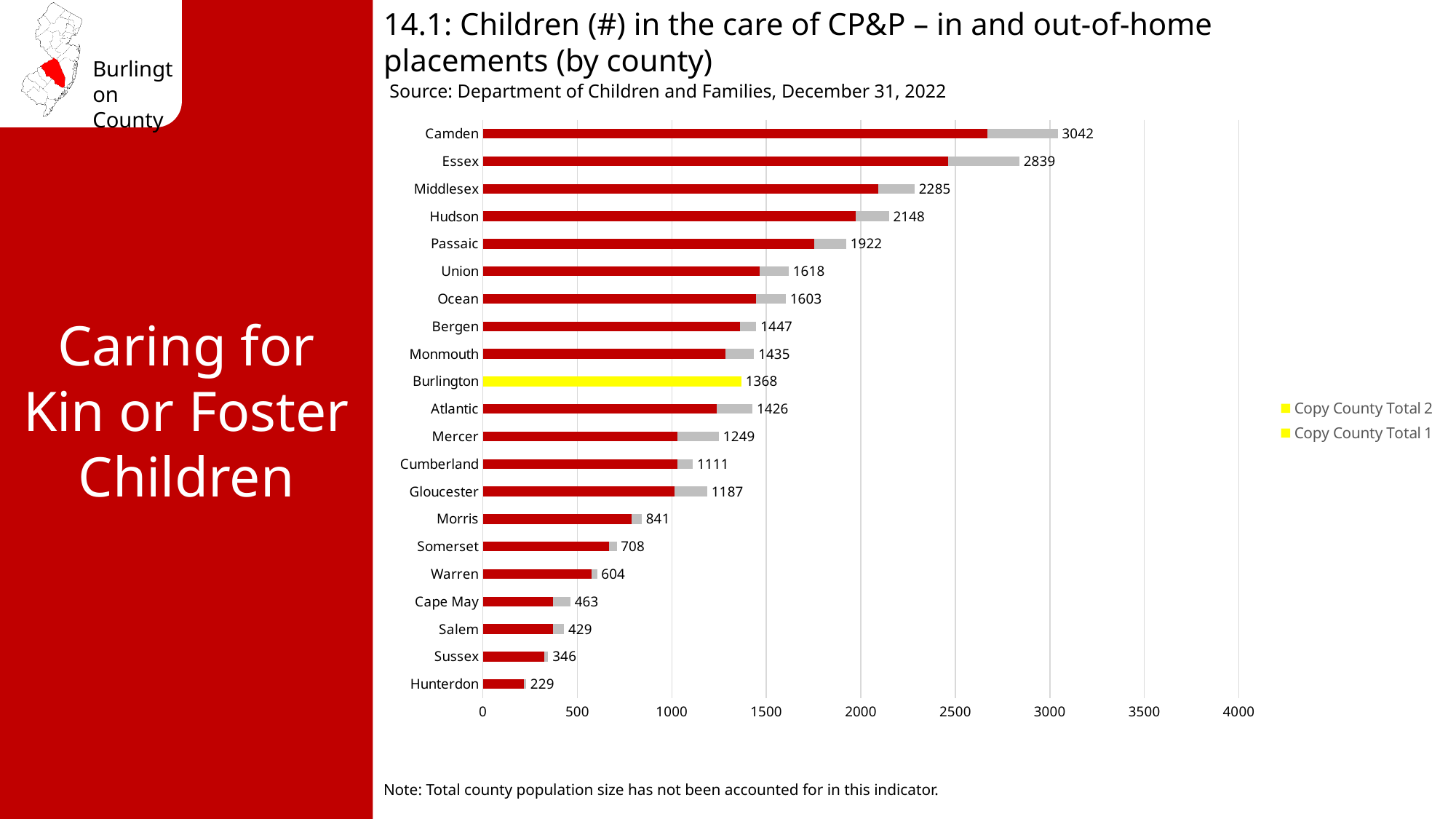
Which county's bar is highlighted in yellow? Burlington What type of chart is shown on the slide? bar chart Which county has the lowest value? Hunterdon What is the value shown for Camden? 3042 What is the value shown for Burlington? 1368 Which has a larger value, Sussex or Salem? Salem How many counties are shown in the chart? 21 What is the value shown for Hunterdon? 229 How many entries does the legend list? 2 What is the difference between the values for Camden and Essex? 203 What is the difference between the values for Atlantic and Burlington? 58 Which county has the highest value? Camden